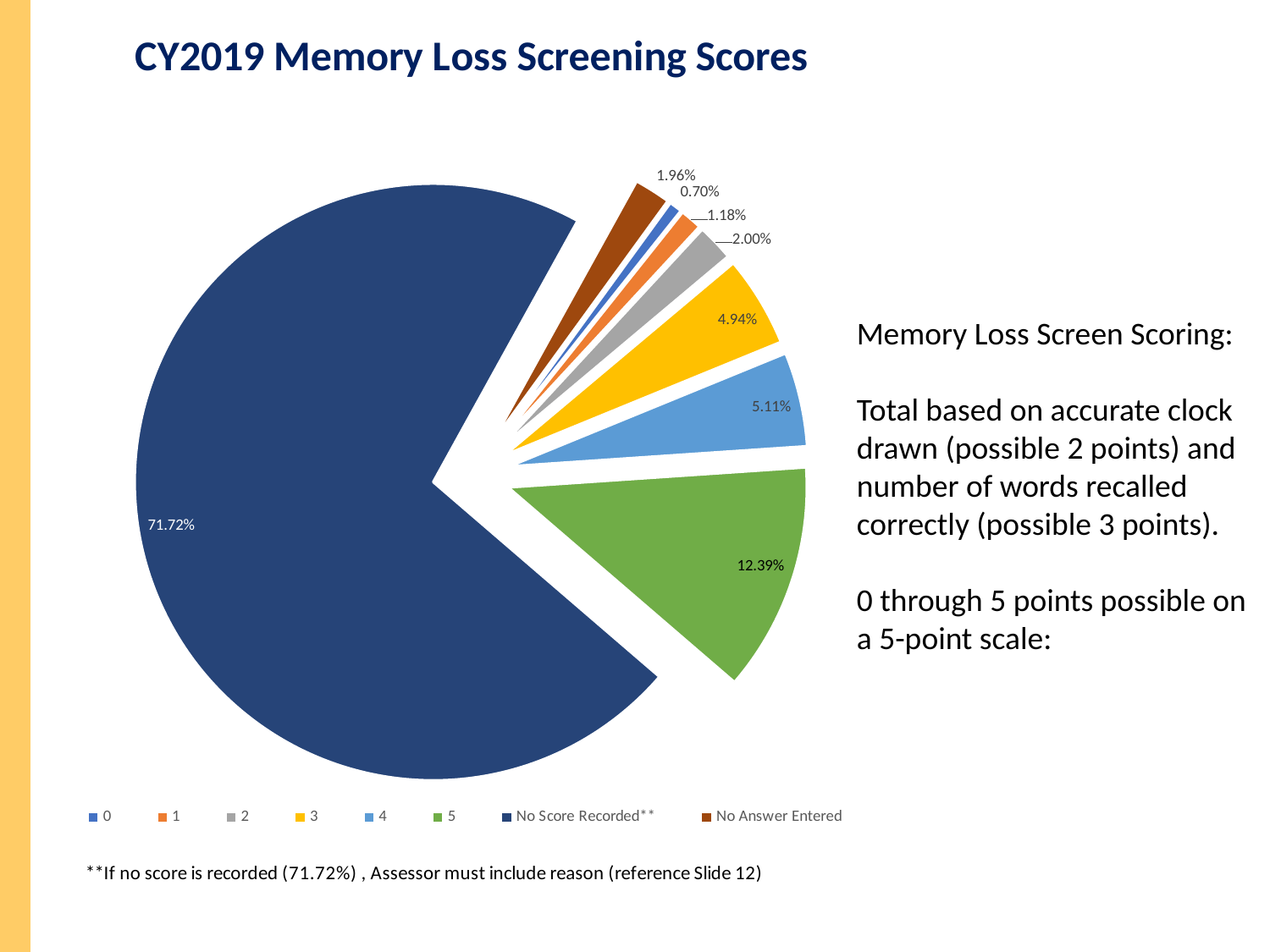
How many categories does the legend list? 8 What percentage is shown for the score of 5? 12.39% What percentage is shown for the 'No Answer Entered' slice? 1.96% What percentage is shown for the score of 4? 5.11% What percentage is shown for the score of 3? 4.94% What percentage of the pie is labelled for the 'No Score Recorded**' slice? 71.72% Which category has the smallest share of the pie? 0 What type of chart is shown on the slide? pie chart What is the difference between the share for score 2 and the share for score 1? 0.82% Which is larger, the share for score 5 or the share for score 4? score 5 Which category has the largest share of the pie? No Score Recorded** What percentage is shown for the score of 0? 0.70%